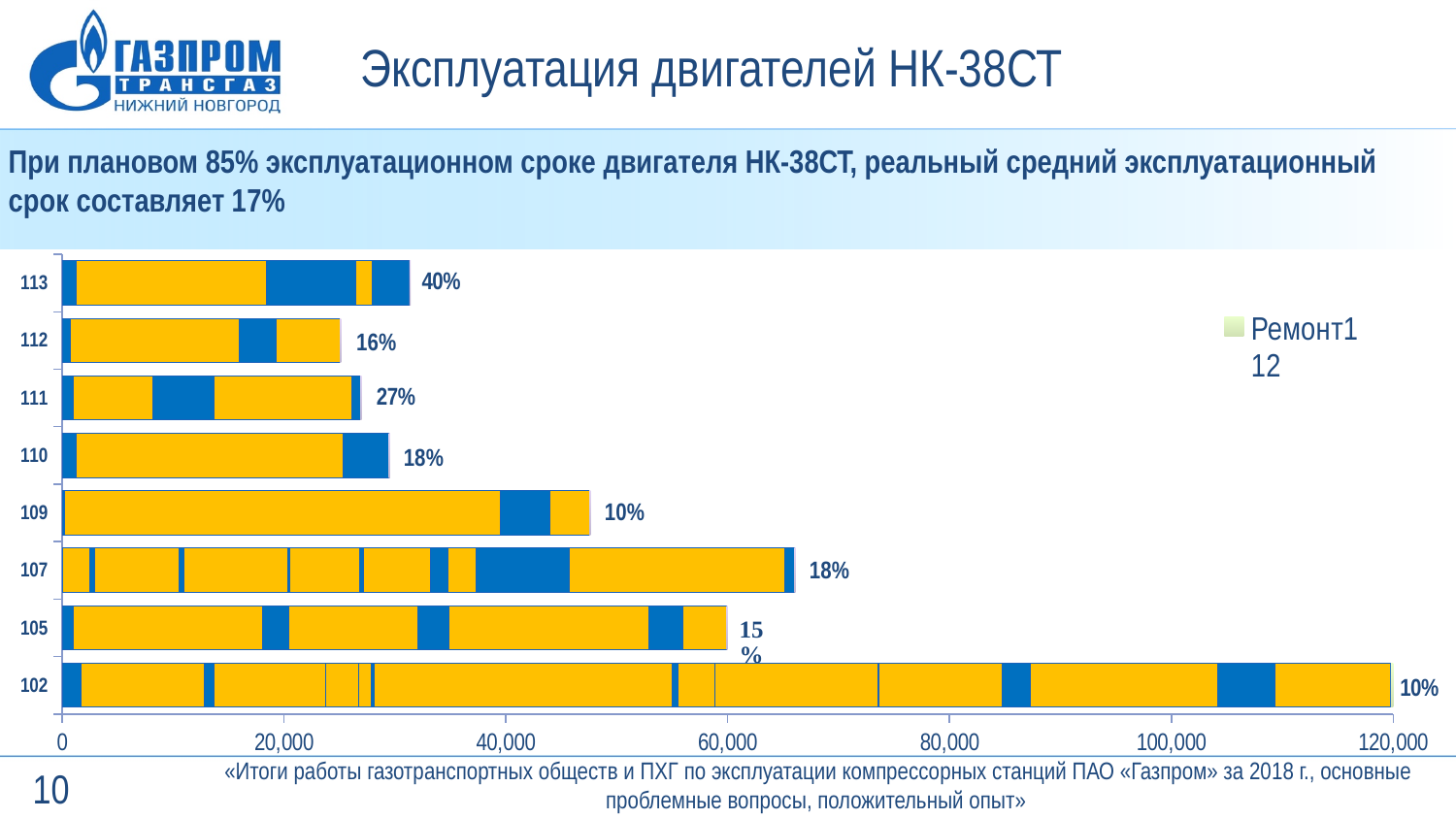
What percentage label is shown for engine 113? 40% How many engines (categories) are shown on the chart? 8 What percentage label is shown for engine 105? 15% Is the total bar length for engine 113 greater or less than 40,000? less Is the total bar length for engine 102 greater or less than 100,000? greater Which has the larger percentage label, engine 110 or engine 111? 111 What type of chart is shown on the slide? Stacked bar chart Which engine has the highest percentage label on the chart? 113 What percentage label is shown for engine 109? 10% Which engine has the longest bar on the chart? 102 What is the difference between the percentage labels for engines 113 and 112? 24 percentage points What percentage label is shown for engine 111? 27%